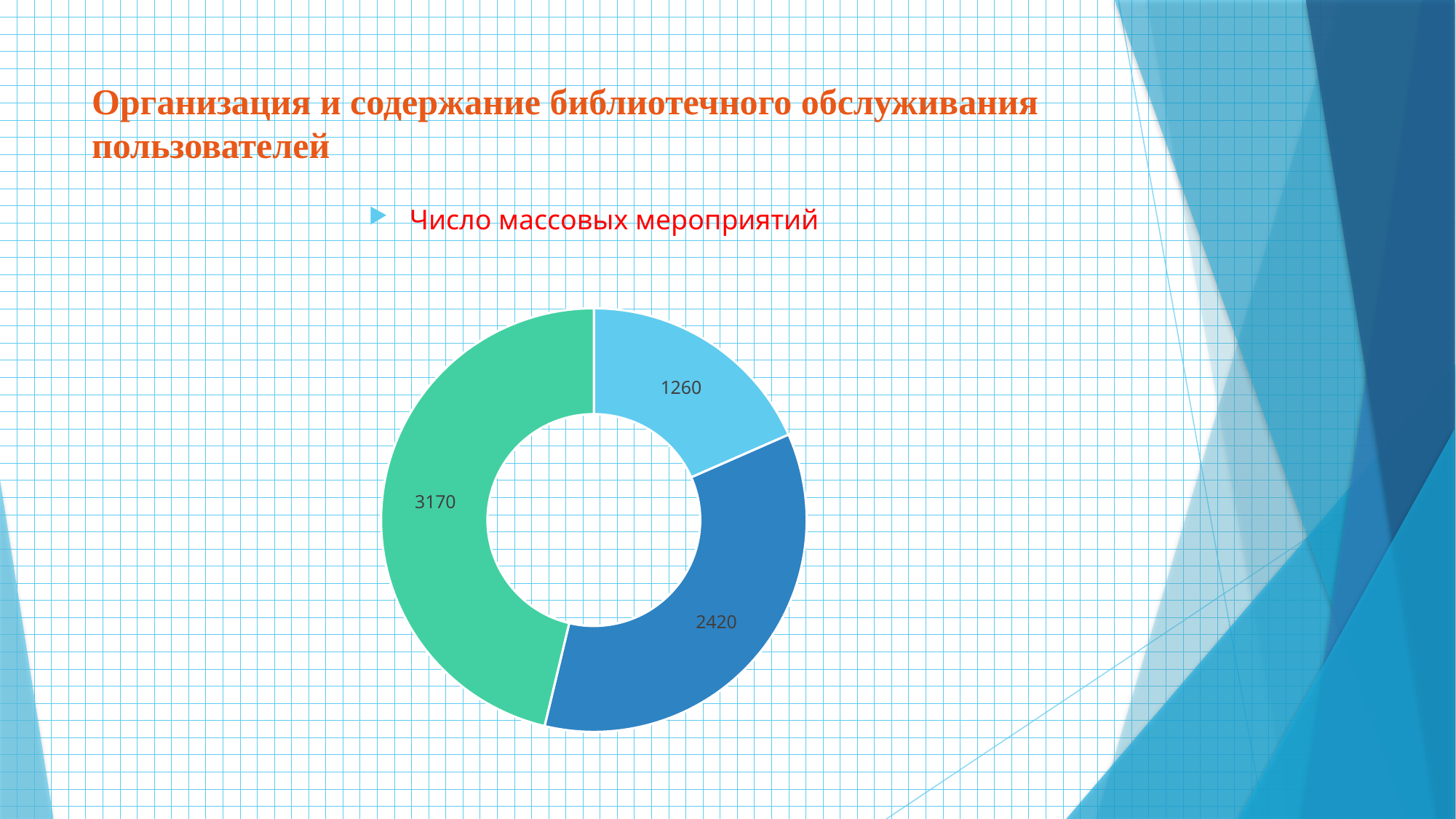
Which slice of the doughnut chart has the largest value? The green slice (3170) What value is labelled on the light blue slice of the doughnut chart? 1260 What is the total of all three values shown on the doughnut chart? 6850 What kind of chart is shown on the slide? Doughnut (pie) chart What is the difference between the largest slice value (3170) and the smallest slice value (1260)? 1910 What value is labelled on the green slice of the doughnut chart? 3170 Which is larger: the green slice or the dark blue slice? The green slice (3170) What text appears in the bullet point above the chart? Число массовых мероприятий What is the difference between the dark blue slice (2420) and the light blue slice (1260)? 1160 How many slices does the doughnut chart have? 3 Which slice of the doughnut chart has the smallest value? The light blue slice (1260) What value is labelled on the dark blue slice of the doughnut chart? 2420